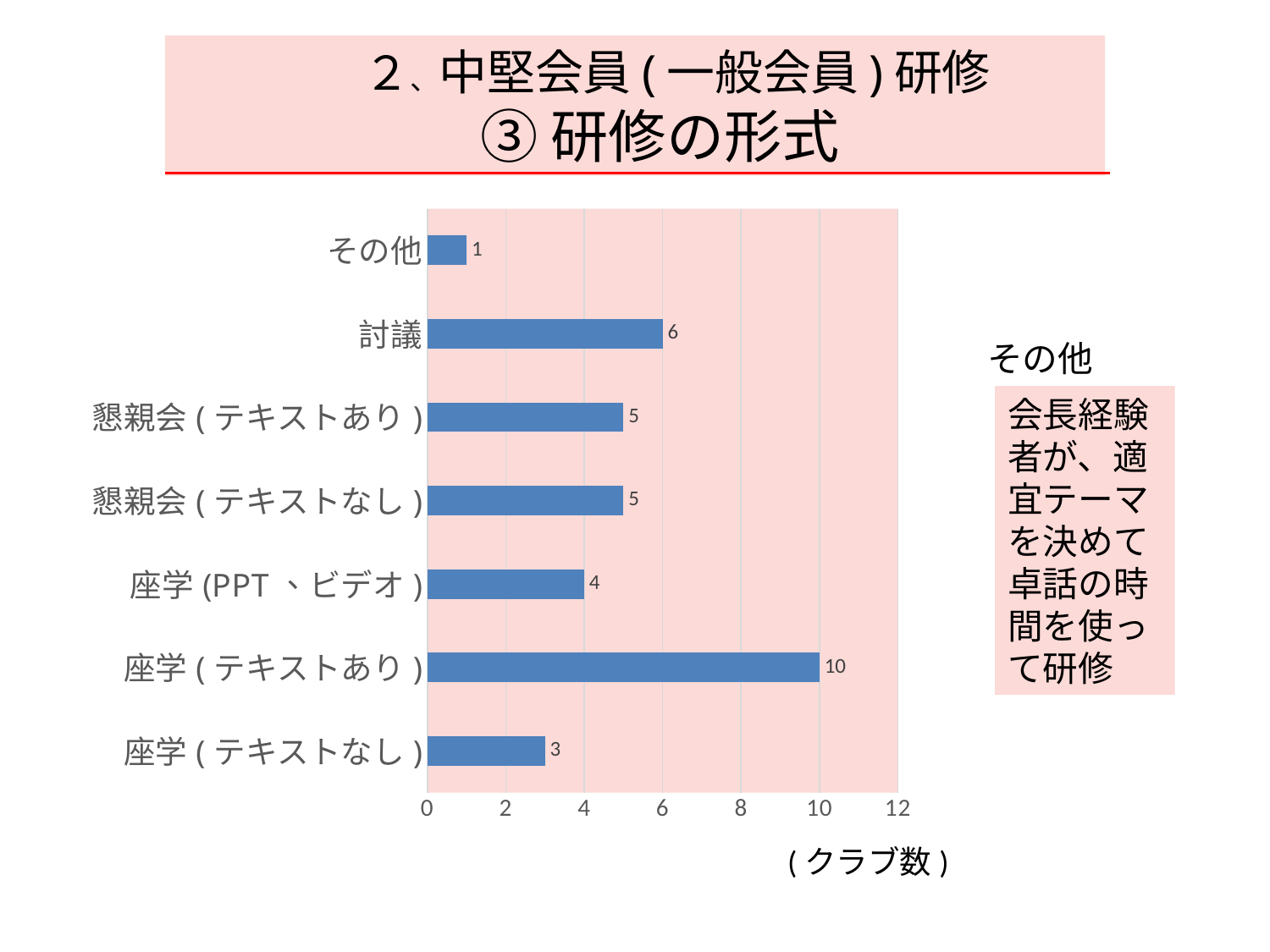
What is the value for 座学(テキストあり)? 10 What kind of chart is shown on the slide? bar chart Which is larger, the value for 討議 or the value for 懇親会(テキストあり)? 討議 What is the value for その他? 1 How many categories are shown in the chart? 7 Which category has the highest value? 座学(テキストあり) What is the value for 座学(PPT、ビデオ)? 4 What unit label is shown below the x axis of the chart? (クラブ数) What is the difference between the values for 座学(テキストあり) and 座学(テキストなし)? 7 Is the value for 座学(テキストあり) greater or less than 8? greater Which category has the lowest value? その他 What is the value for 討議? 6